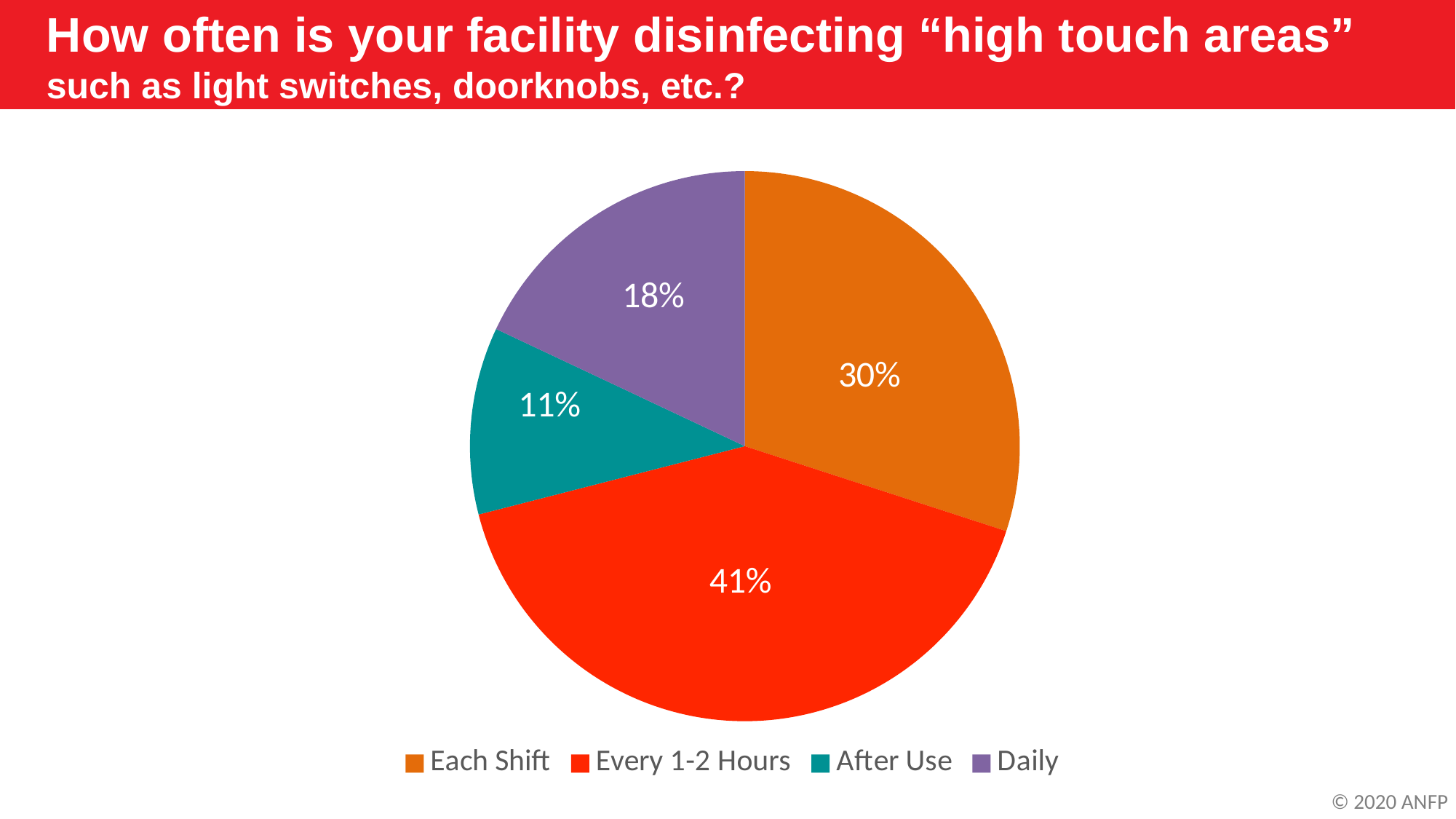
Which disinfecting frequency has the smallest share of the pie? After Use How many categories are shown in the pie chart? 4 What is the difference in percentage points between Every 1-2 Hours and Each Shift? 11 What type of chart is shown on the slide? Pie chart Which is larger, the share for Daily or the share for After Use? Daily Which colour represents the After Use category in the legend? Teal Which disinfecting frequency has the largest share of the pie? Every 1-2 Hours What is the combined share of Each Shift and Every 1-2 Hours? 71% What percentage of facilities disinfect high touch areas every 1-2 hours? 41% What percentage of facilities disinfect high touch areas after use? 11% What percentage of facilities disinfect high touch areas daily? 18% What percentage of facilities disinfect high touch areas each shift? 30%